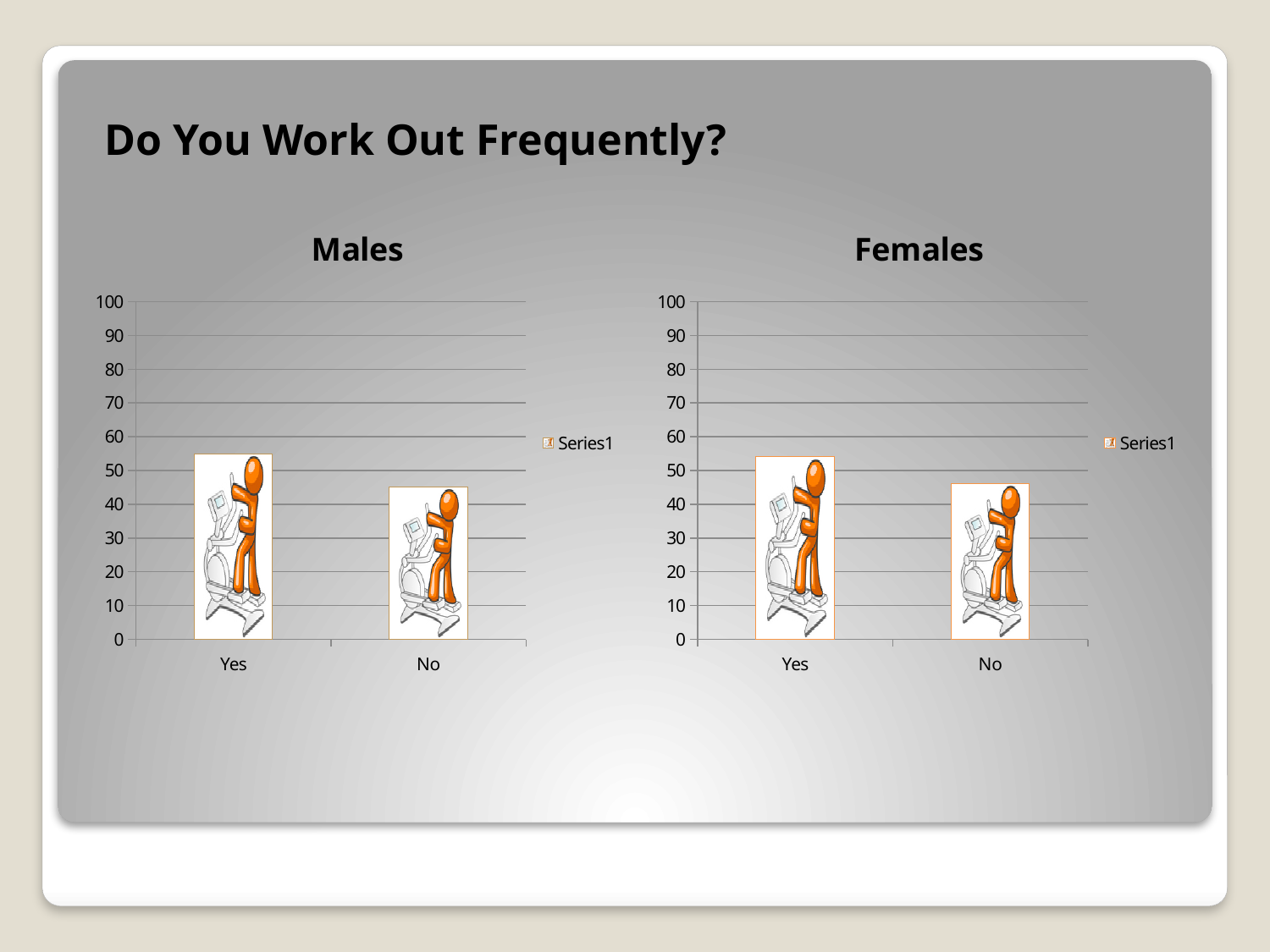
How many categories are shown on the x axis of the Females chart? 2 In the Males chart, which category has the highest value? Yes What is the title of the chart on the right side of the slide? Females In the Males chart, is the value for No greater or less than 50? less In the Males chart, is the value for Yes greater or less than 50? greater In the Females chart, is the value for Yes greater or less than 50? greater What kind of chart is the Males chart? bar chart In the Females chart, which category has the highest value? Yes How many series does the legend of the Males chart list? 1 In the Males chart, which category has the lowest value? No In the Females chart, which category has the lowest value? No